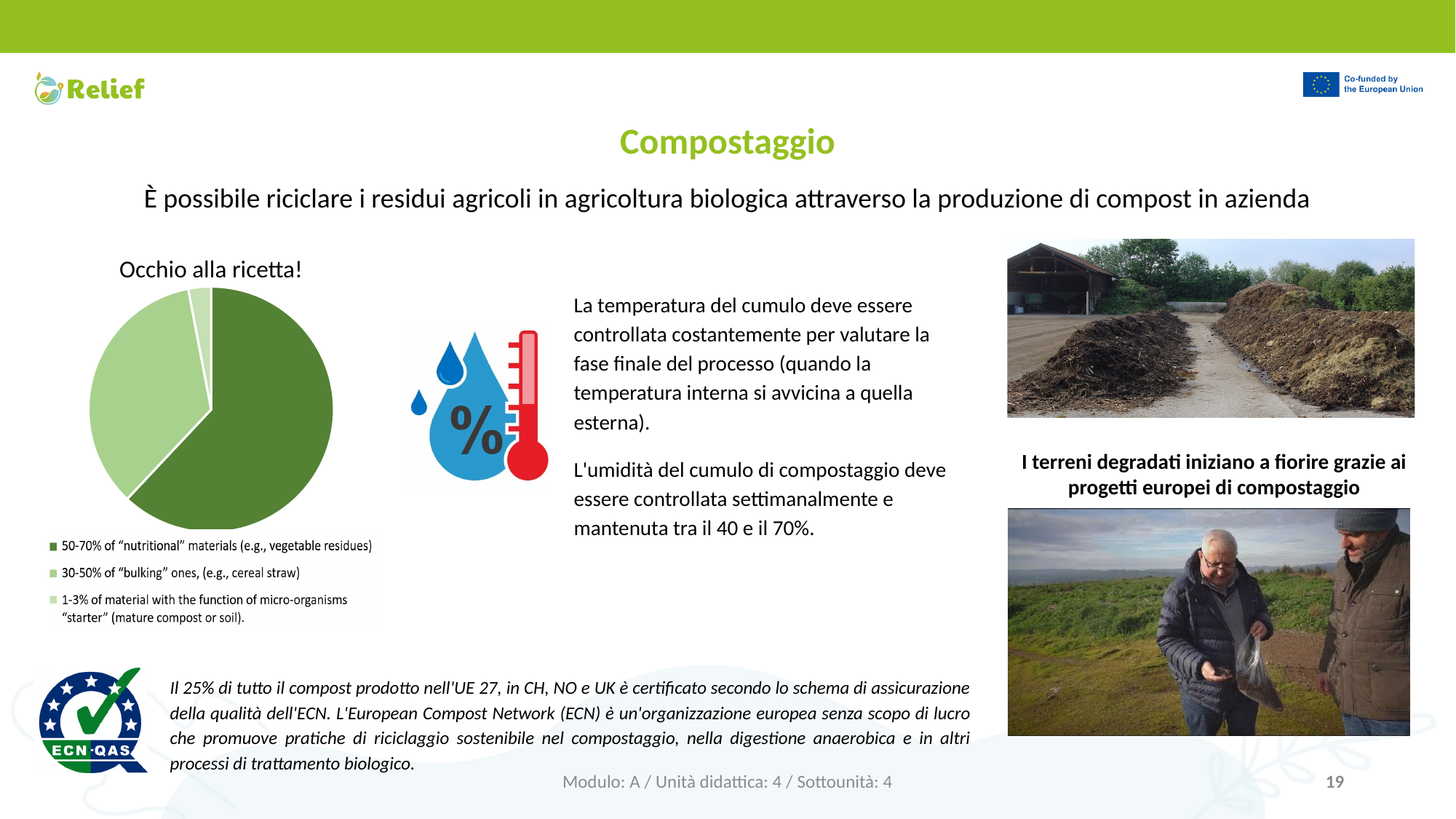
In the pie chart, which slice is larger: "bulking" ones or the micro-organisms "starter" material? "bulking" ones How many slices does the pie chart have? 3 What heading appears directly above the pie chart? Occhio alla ricetta! Does the largest slice of the pie chart cover more or less than half of the pie? more What kind of chart is shown under the heading "Occhio alla ricetta!"? Pie chart How many entries does the legend of the pie chart list? 3 Which legend category takes up the largest slice of the pie chart? 50-70% of "nutritional" materials (e.g., vegetable residues) Which legend category takes up the smallest slice of the pie chart? 1-3% of material with the function of micro-organisms "starter" (mature compost or soil) What colour is the slice for "50-70% of "nutritional" materials" in the pie chart? Dark green In the pie chart, which slice is larger: "nutritional" materials or "bulking" ones? "nutritional" materials